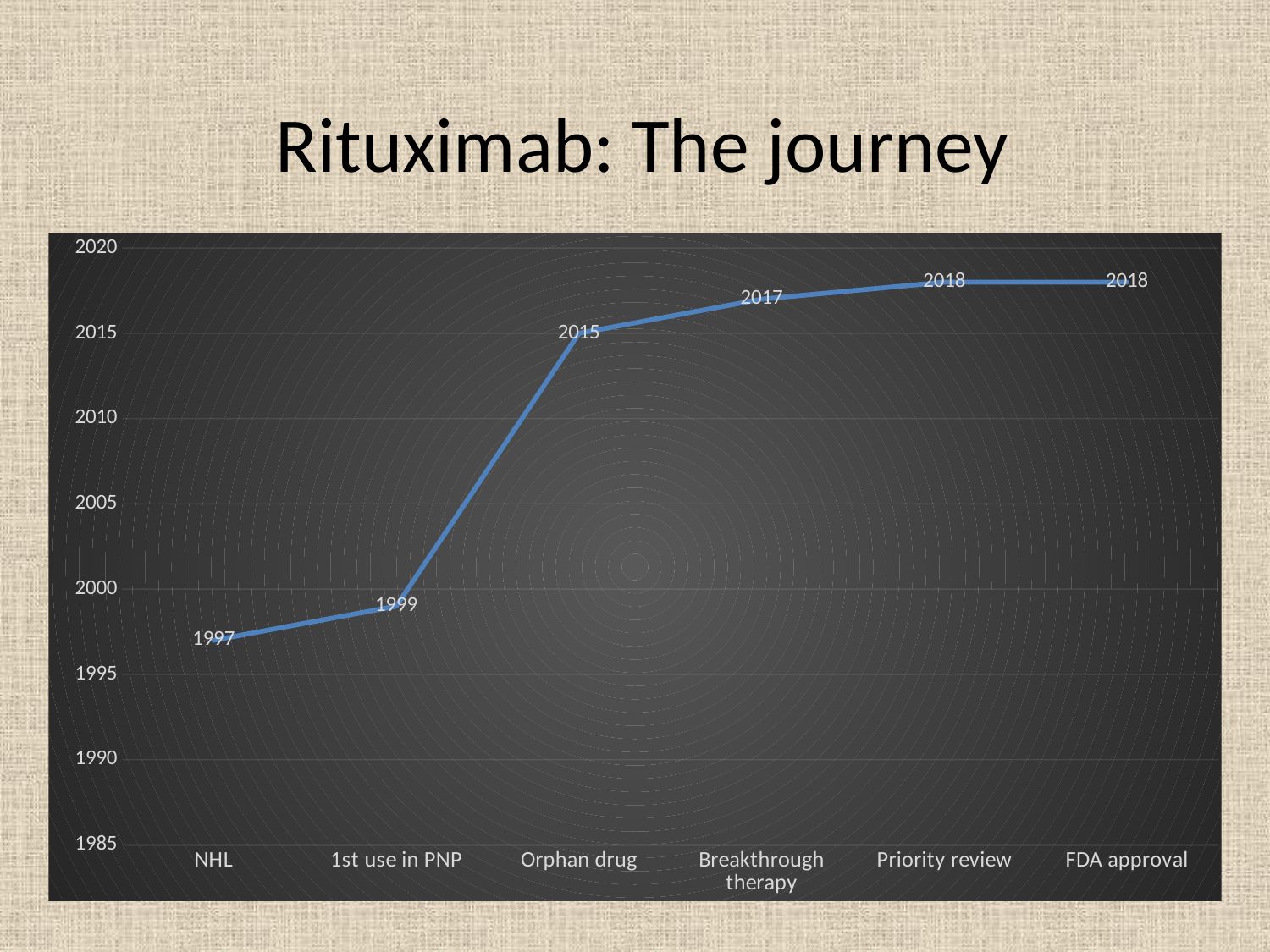
Which category has the lowest value? NHL What is the value for FDA approval? 2018 Do the values rise or fall from NHL to FDA approval? rise What type of chart is shown on the slide? line chart What is the value for 1st use in PNP? 1999 How many categories are shown on the x axis? 6 What is the value for Breakthrough therapy? 2017 What is the value for Orphan drug? 2015 Is the value for 1st use in PNP greater or less than 2000? less What is the difference between the values for Orphan drug and 1st use in PNP? 16 Which is larger, the value for Breakthrough therapy or the value for Orphan drug? Breakthrough therapy What is the value for NHL? 1997